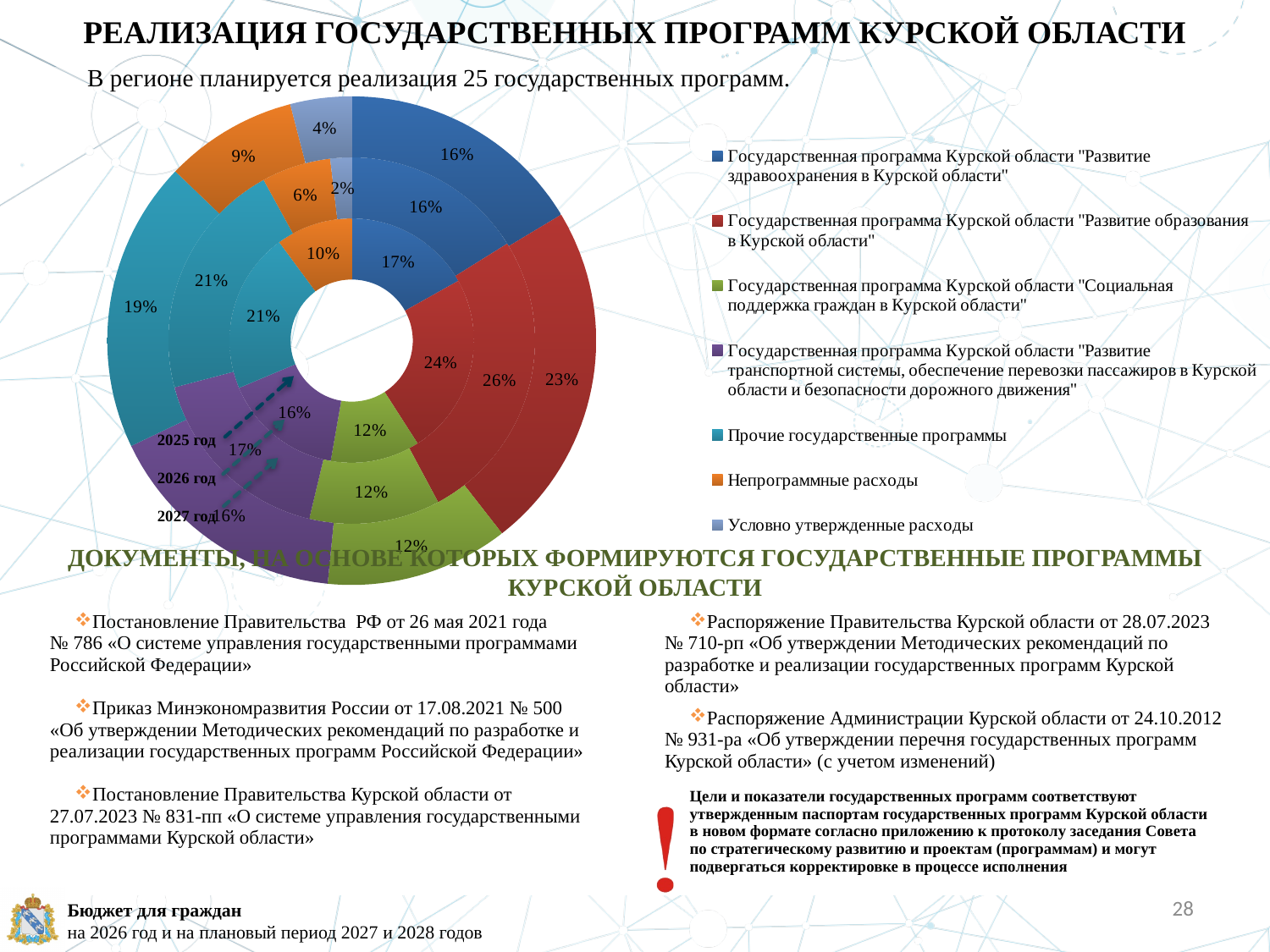
What share does "Социальная поддержка граждан в Курской области" have in the middle ring of the chart? 12% In the outer ring of the chart, which category has the largest share? Государственная программа Курской области "Развитие образования в Курской области" In the middle ring of the chart, what share is shown for "Непрограммные расходы"? 6% In the inner ring, which is larger: the share for "Прочие государственные программы" or the share for "Развитие транспортной системы"? Прочие государственные программы How many entries does the chart legend list? 7 In the outer ring of the chart, which category has the smallest share? Условно утвержденные расходы How many rings does the doughnut chart have? 3 What colour represents "Развитие образования в Курской области" in the chart? red In the outer ring of the chart, what share is shown for "Условно утвержденные расходы"? 4% What kind of chart is shown on the slide? doughnut chart In the inner ring of the chart, what share is shown for the program "Развитие образования в Курской области"? 24% In the outer ring, what is the difference between the share for "Развитие образования" (23%) and the share for "Развитие здравоохранения" (16%)? 7 percentage points